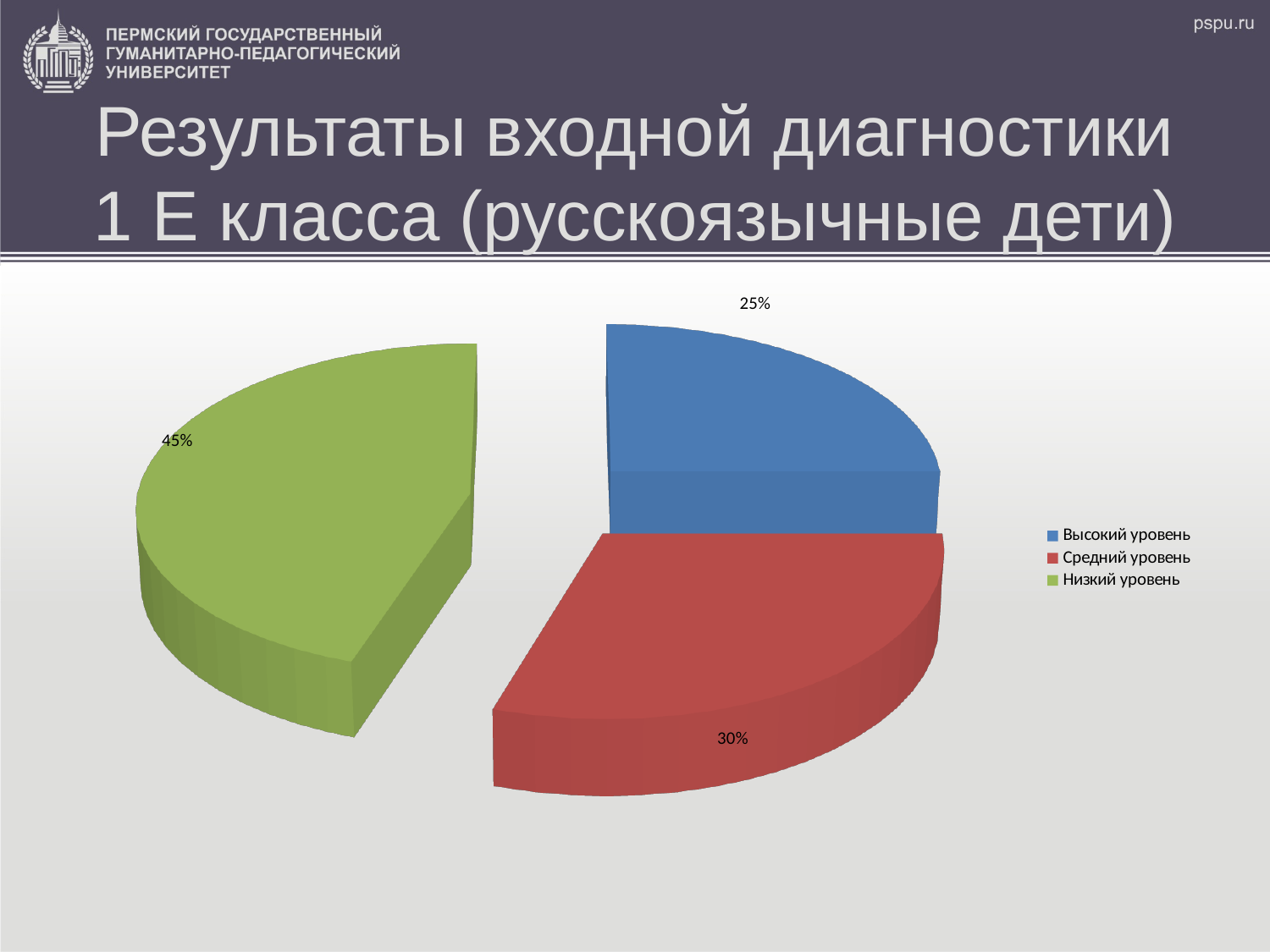
What share of the pie does Высокий уровень have? 25% How many categories does the pie chart show? 3 What is the difference in percentage points between Средний уровень and Высокий уровень? 5 Which category has the smallest share of the pie? Высокий уровень What share of the pie does Средний уровень have? 30% Which is larger, the share for Средний уровень or the share for Низкий уровень? Низкий уровень What colour is the slice for Низкий уровень? green What is the difference in percentage points between Низкий уровень and Высокий уровень? 20 What share of the pie does Низкий уровень have? 45% Which category has the largest share of the pie? Низкий уровень Which legend entry is shown in red? Средний уровень What kind of chart is shown on the slide? pie chart